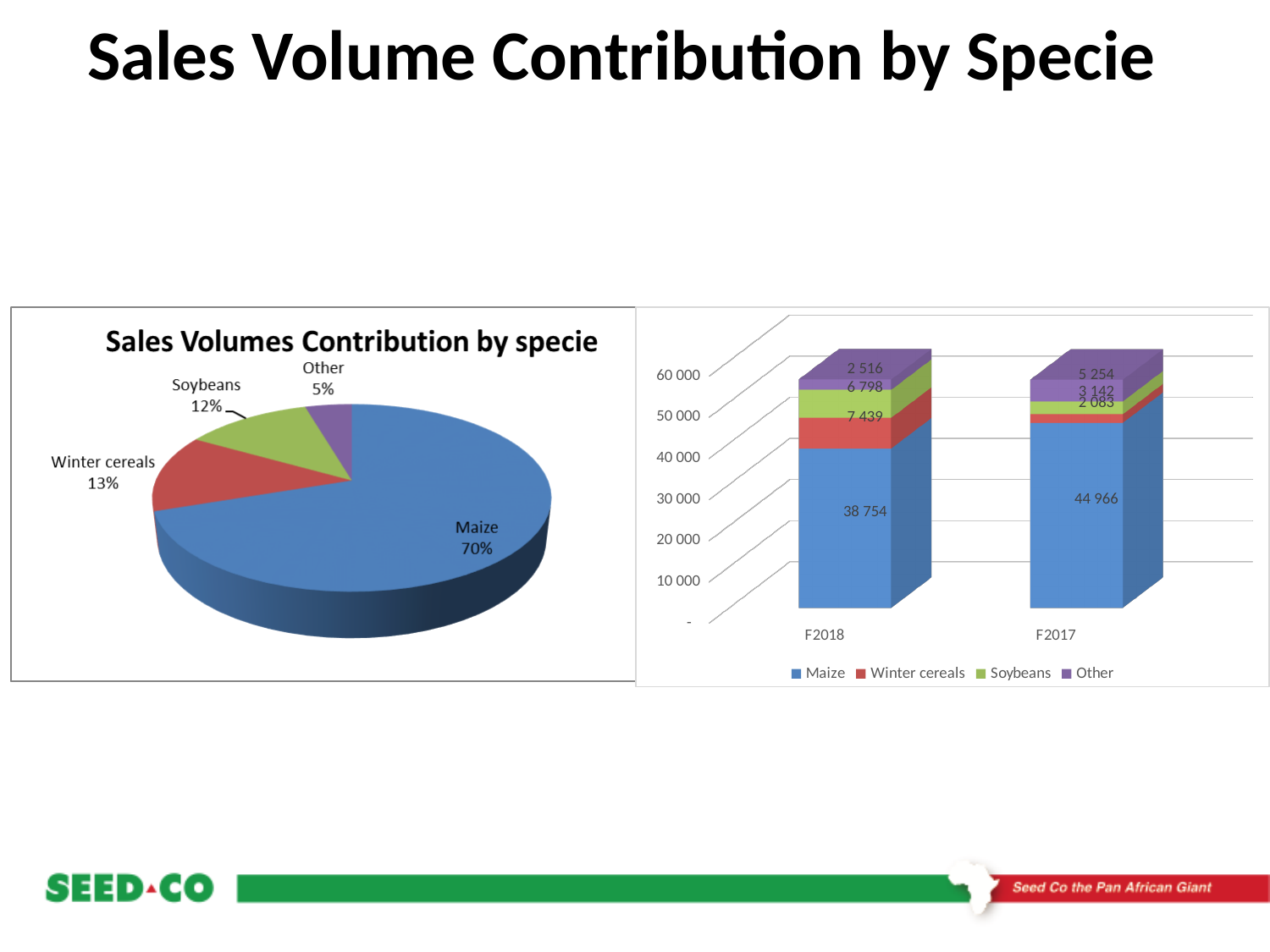
How many series does the legend of the stacked bar chart on the right list? 4 In the pie chart on the left, what percentage is shown for Winter cereals? 13% In the pie chart on the left, how many slices are there? 4 In the stacked bar chart on the right, what is the Other value for F2017? 5 254 In the pie chart on the left, which specie has the largest share? Maize In the pie chart on the left, what share of sales volume does Maize contribute? 70% What type of chart is the chart on the left? Pie chart In the pie chart on the left, which specie has the smallest share? Other In the stacked bar chart on the right, what is the difference between the Maize values for F2017 and F2018? 6 212 In the stacked bar chart on the right, what is the total of the F2018 bar? 55 507 In the stacked bar chart on the right, what is the Maize value for F2018? 38 754 In the stacked bar chart on the right, what is the Maize value for F2017? 44 966